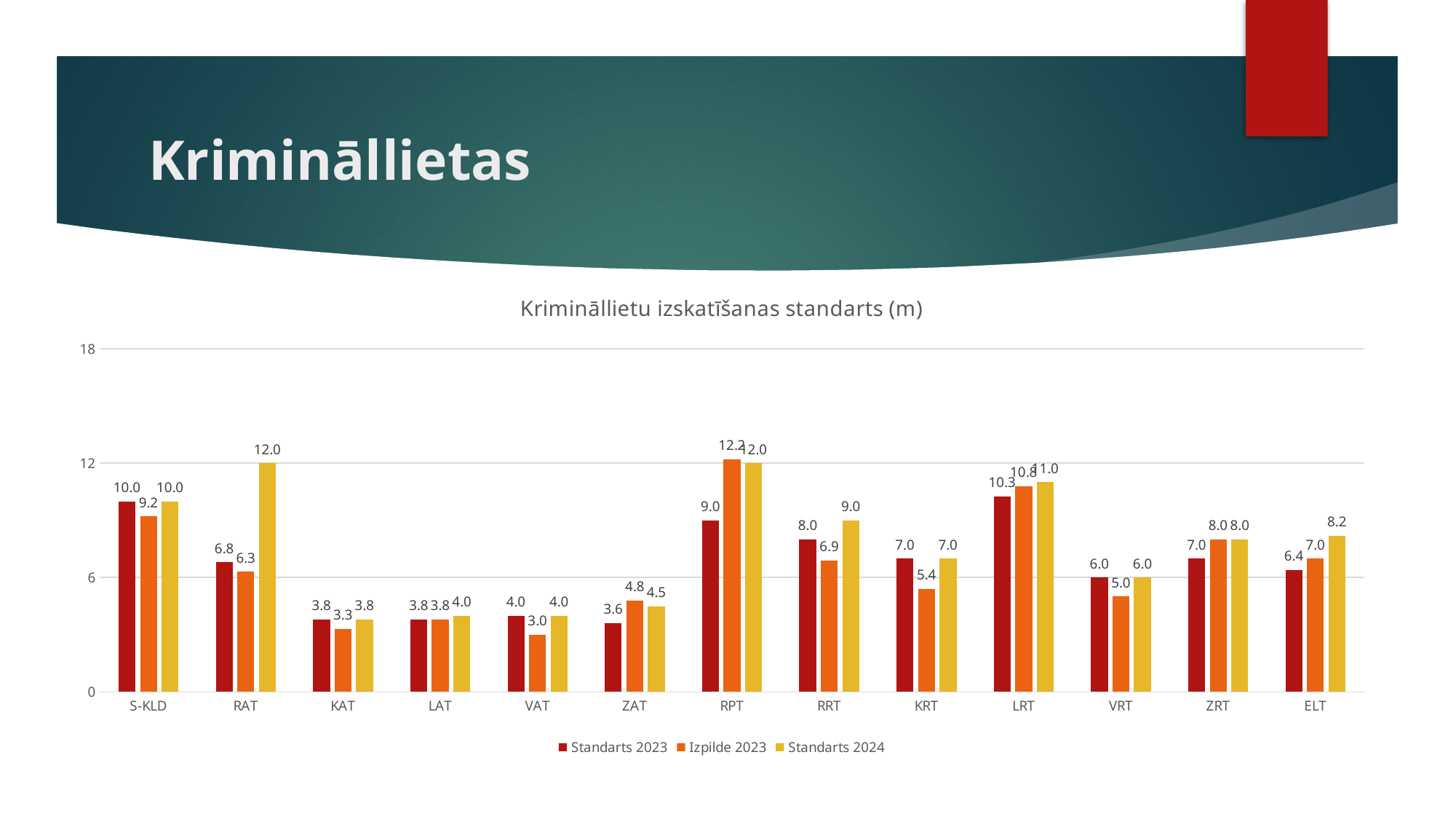
What is the Standarts 2024 value for RAT? 12.0 Which category has the lowest Standarts 2023 value? ZAT Which is larger for RRT: the Standarts 2023 value or the Izpilde 2023 value? Standarts 2023 What is the Izpilde 2023 value for KRT? 5.4 Which category has the lowest Izpilde 2023 value? VAT What kind of chart is shown on the slide? Bar chart What is the difference between the Standarts 2024 and Standarts 2023 values for ELT? 1.8 What is the title of the chart? Krimināllietu izskatīšanas standarts (m) Which category has the highest Izpilde 2023 value? RPT How many categories are shown on the x axis? 13 How many series does the legend list? 3 What is the Standarts 2023 value for LRT? 10.3